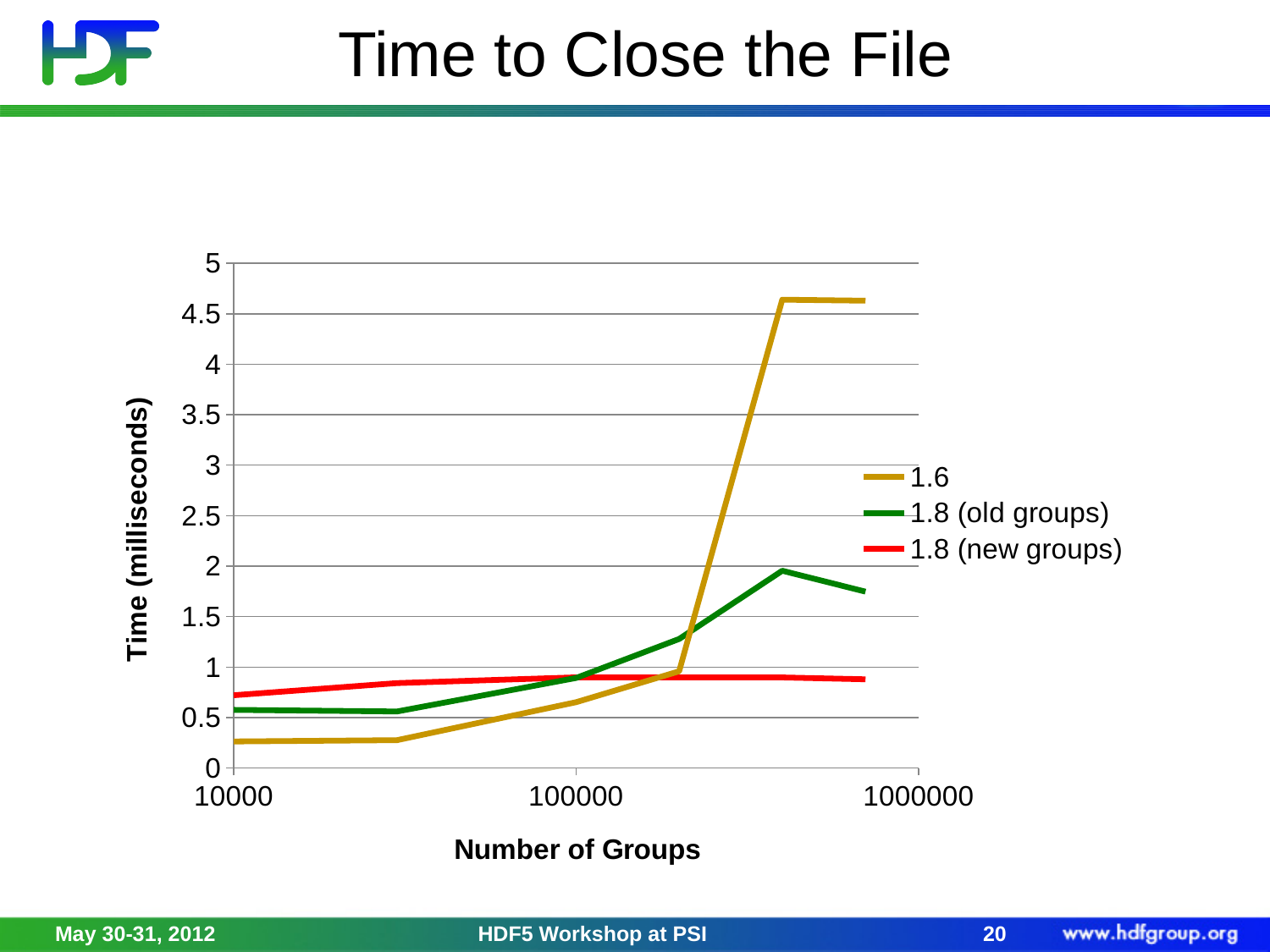
Is the value for 1.8 (new groups) at 10000 groups greater or less than 1? less How many series does the legend list? 3 Is the value for 1.8 (new groups) at 100000 groups greater or less than 0.5? greater What is the title of the y axis? Time (milliseconds) Which series reaches the highest time value on the chart? 1.6 Is the peak value of the 1.8 (old groups) series greater or less than 1.5? greater Does the 1.6 series generally rise or fall as the number of groups increases? rise At the rightmost point, which is larger: 1.8 (old groups) or 1.8 (new groups)? 1.8 (old groups) Which series has the lowest value at 10000 groups? 1.6 At 10000 groups, which is larger: 1.6 or 1.8 (old groups)? 1.8 (old groups) What kind of chart is shown on the slide? line chart